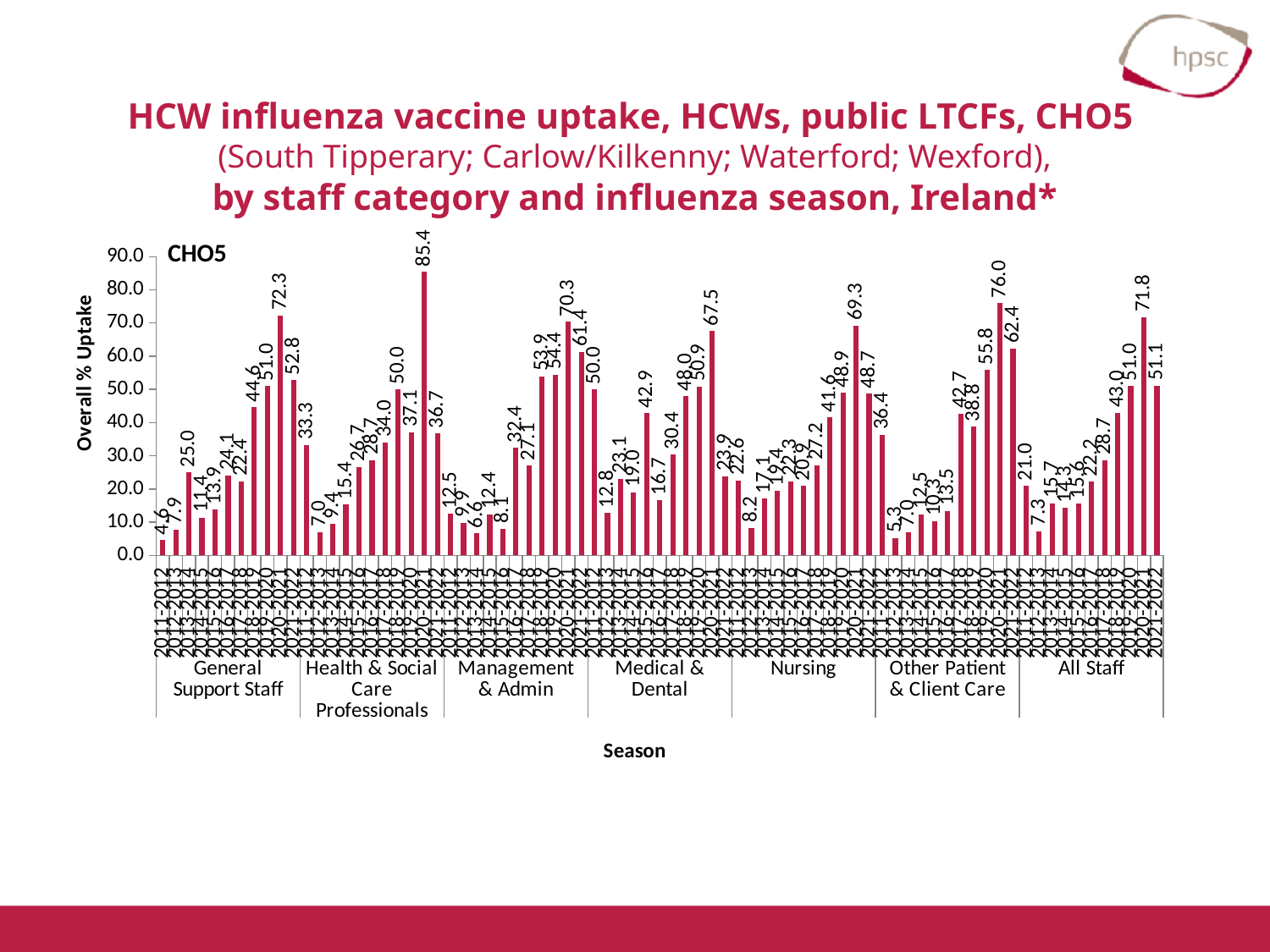
What is the highest value shown in the Other Patient & Client Care group? 76.0 What is the highest value shown in the Health & Social Care Professionals group? 85.4 What is the lowest value shown in the Nursing group? 8.2 What is the highest value shown in the All Staff group? 71.8 How many staff categories are shown along the x axis? 7 What is the difference between the highest value in the Health & Social Care Professionals group (85.4) and the highest value in the General Support Staff group (72.3)? 13.1 What is the title of the vertical axis? Overall % Uptake What kind of chart is shown on the slide? Bar chart Which is larger: the peak value in the Nursing group or the peak value in the Medical & Dental group? Nursing (69.3) What is the lowest value shown in the General Support Staff group? 4.6